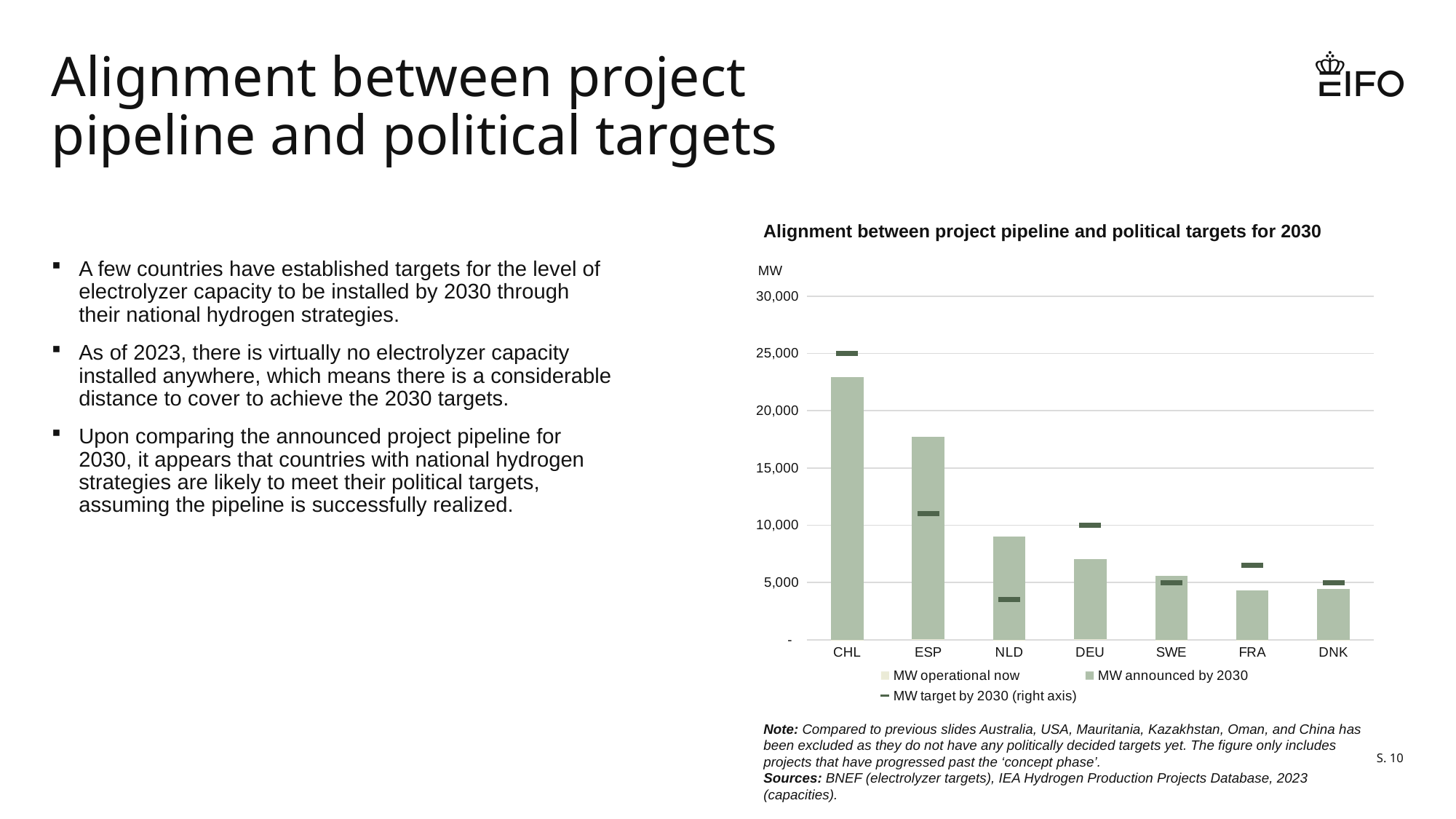
How many countries are shown on the x axis of the chart? 7 Is the MW announced by 2030 for DEU greater or less than 10,000? less What type of chart is shown on the slide? bar chart What is the title of the chart? Alignment between project pipeline and political targets for 2030 How many series does the chart legend list? 3 What unit is shown on the vertical axis of the chart? MW Do the MW announced by 2030 bars generally rise or fall from left to right across the countries? fall Is the MW announced by 2030 for ESP greater or less than 15,000? greater Which has a larger MW announced by 2030, ESP or NLD? ESP Which country has the highest MW announced by 2030? CHL Is the MW announced by 2030 for CHL greater or less than 20,000? greater